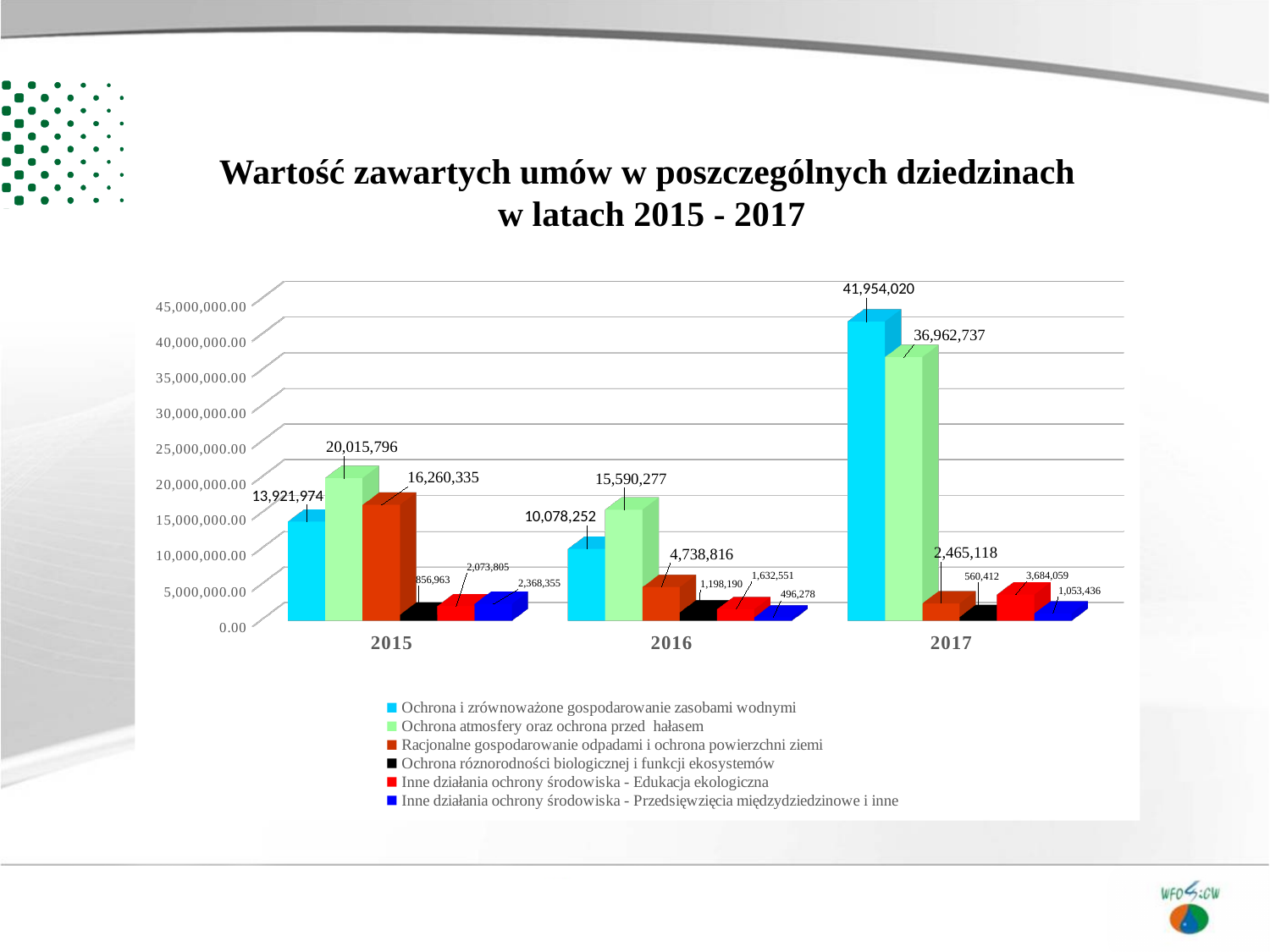
In 2015, which is larger: 'Ochrona atmosfery oraz ochrona przed hałasem' or 'Racjonalne gospodarowanie odpadami i ochrona powierzchni ziemi'? Ochrona atmosfery oraz ochrona przed hałasem What is the title of the chart on the slide? Wartość zawartych umów w poszczególnych dziedzinach w latach 2015 - 2017 Which series has the lowest value in 2016? Inne działania ochrony środowiska - Przedsięwzięcia międzydziedzinowe i inne What is the value for 'Ochrona i zrównoważone gospodarowanie zasobami wodnymi' in 2017? 41,954,020 What is the value for 'Racjonalne gospodarowanie odpadami i ochrona powierzchni ziemi' in 2016? 4,738,816 Which year has the highest value for 'Ochrona i zrównoważone gospodarowanie zasobami wodnymi'? 2017 What type of chart is shown on the slide? bar chart What is the value for 'Ochrona atmosfery oraz ochrona przed hałasem' in 2015? 20,015,796 How many year categories are shown on the x axis? 3 What is the difference between the 'Ochrona i zrównoważone gospodarowanie zasobami wodnymi' value and the 'Ochrona atmosfery oraz ochrona przed hałasem' value in 2017? 4,991,283 How many series does the legend list? 6 Does the value for 'Ochrona i zrównoważone gospodarowanie zasobami wodnymi' rise or fall from 2015 to 2016? fall